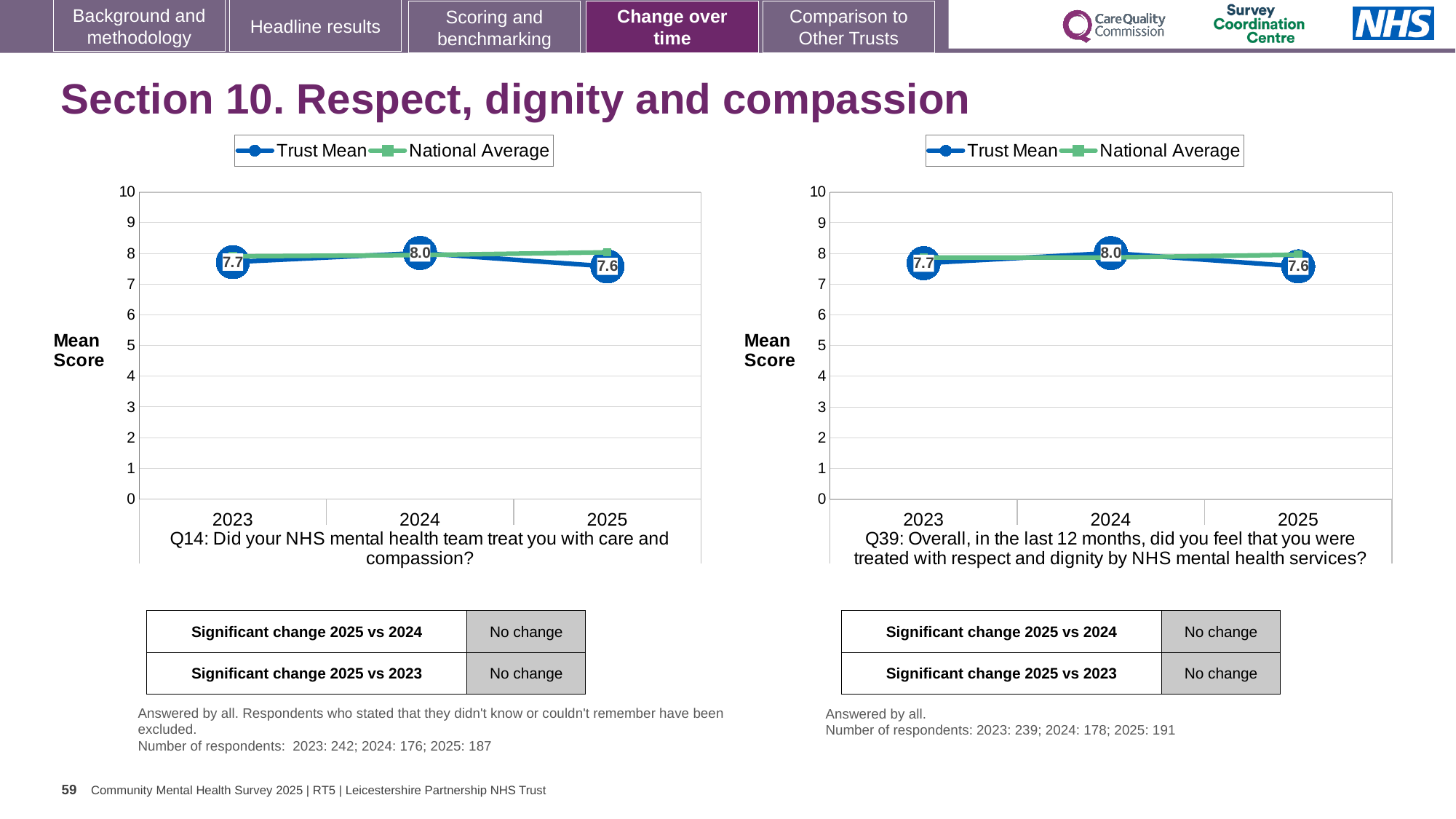
On the left chart (Q14), what is the Trust Mean for 2024? 8.0 How many years are plotted on the x axis of the left chart (Q14)? 3 On the right chart (Q39), what is the Trust Mean for 2023? 7.7 On the left chart (Q14), in which year is the Trust Mean lowest? 2025 What kind of chart is the left chart (Q14)? Line chart On the left chart (Q14), does the Trust Mean rise or fall from 2024 to 2025? Fall On the right chart (Q39), in which year is the Trust Mean highest? 2024 On the left chart (Q14), what is the Trust Mean for 2025? 7.6 How many series does the legend of the right chart (Q39) list? 2 On the right chart (Q39), which is larger, the Trust Mean for 2023 or for 2024? 2024 On the right chart (Q39), is the National Average for 2025 greater or less than 7? greater On the left chart (Q14), what is the difference between the Trust Mean in 2024 and in 2025? 0.4